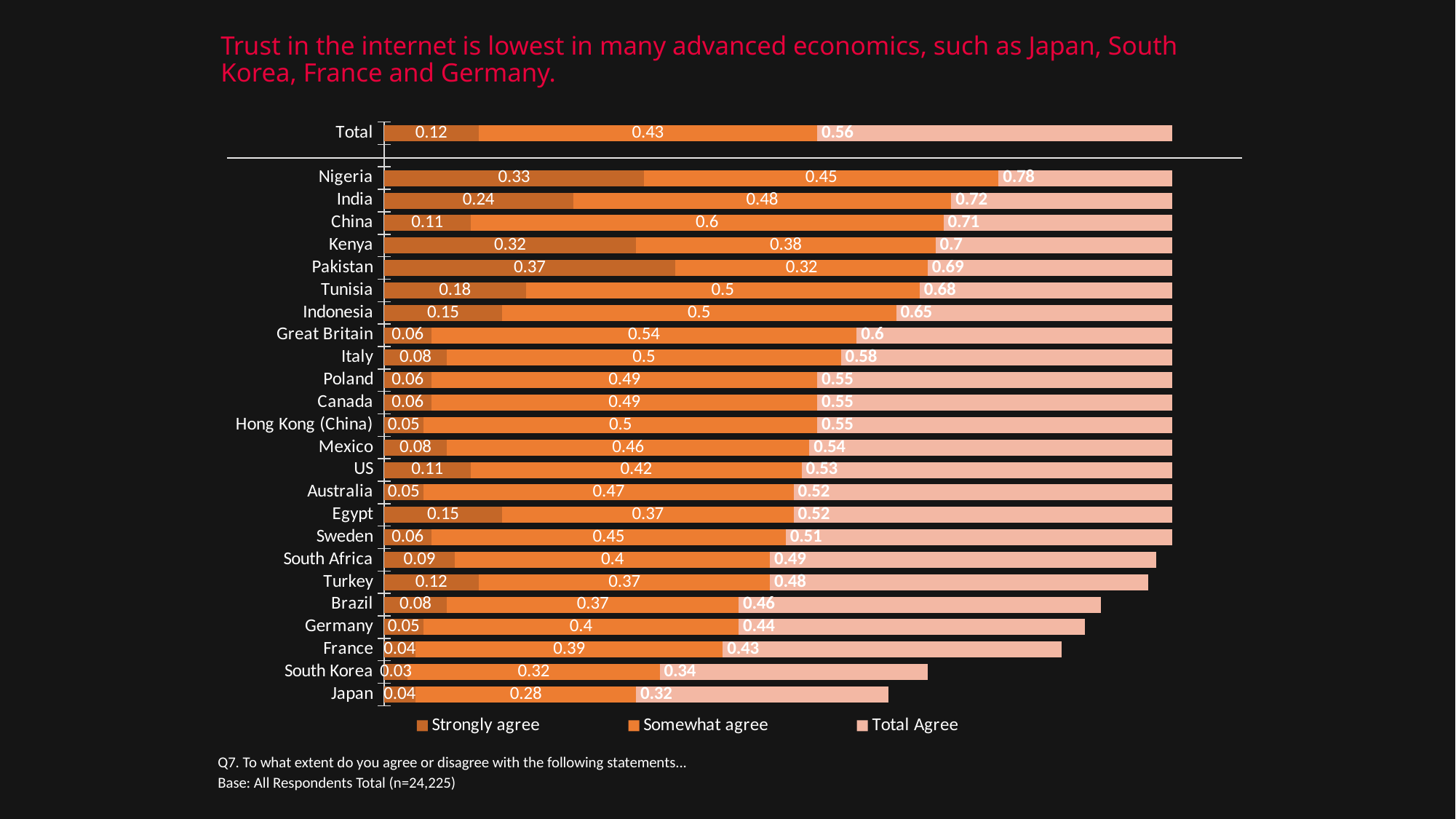
What type of chart is shown on the slide? Stacked bar chart What is the Strongly agree value for Pakistan? 0.37 What is the difference between the Total Agree values for Nigeria and Japan? 0.46 What is the Somewhat agree value for China? 0.6 Which country has the lowest Total Agree value? Japan Which country has the highest Strongly agree value? Pakistan How many countries are listed in the chart, excluding the Total row? 24 What is the Total Agree value for the Total row? 0.56 Which country has the highest Total Agree value? Nigeria How many series does the legend list? 3 What is the Total Agree value for Nigeria? 0.78 Which has a larger Total Agree value, Germany or Kenya? Kenya